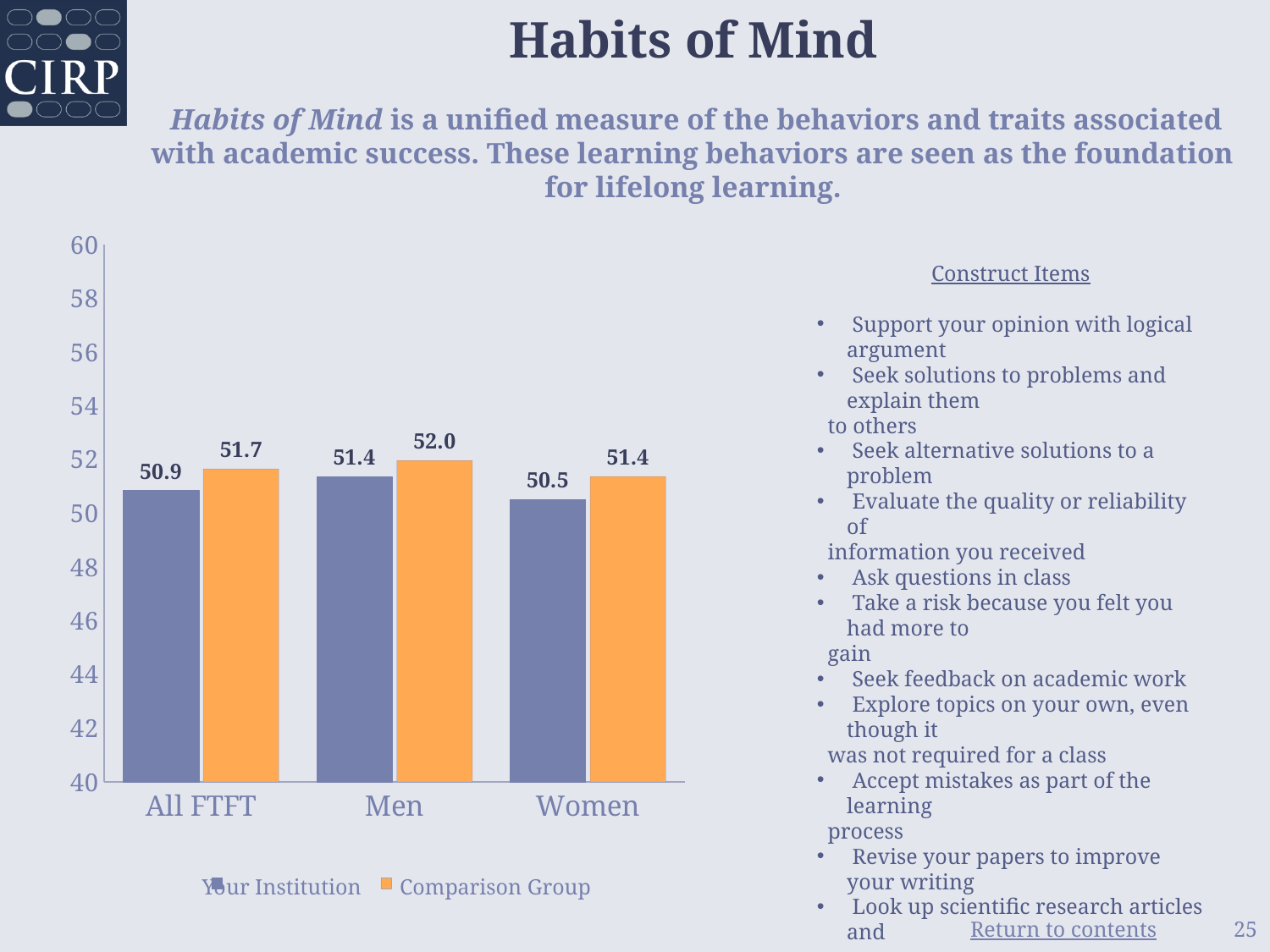
What kind of chart is shown on the slide? Bar chart What is the title of the slide containing the chart? Habits of Mind How many categories are shown on the x axis? 3 Which category has the lowest value for Your Institution? Women What is the value for the Comparison Group in the Men category? 52.0 What is the value for Your Institution in the All FTFT category? 50.9 What is the value for Your Institution in the Women category? 50.5 What is the value for the Comparison Group in the Women category? 51.4 What is the difference between the Comparison Group and Your Institution values in the Women category? 0.9 Which category has the highest value for the Comparison Group? Men In the All FTFT category, which is larger: Your Institution or the Comparison Group? Comparison Group How many series does the legend list? 2